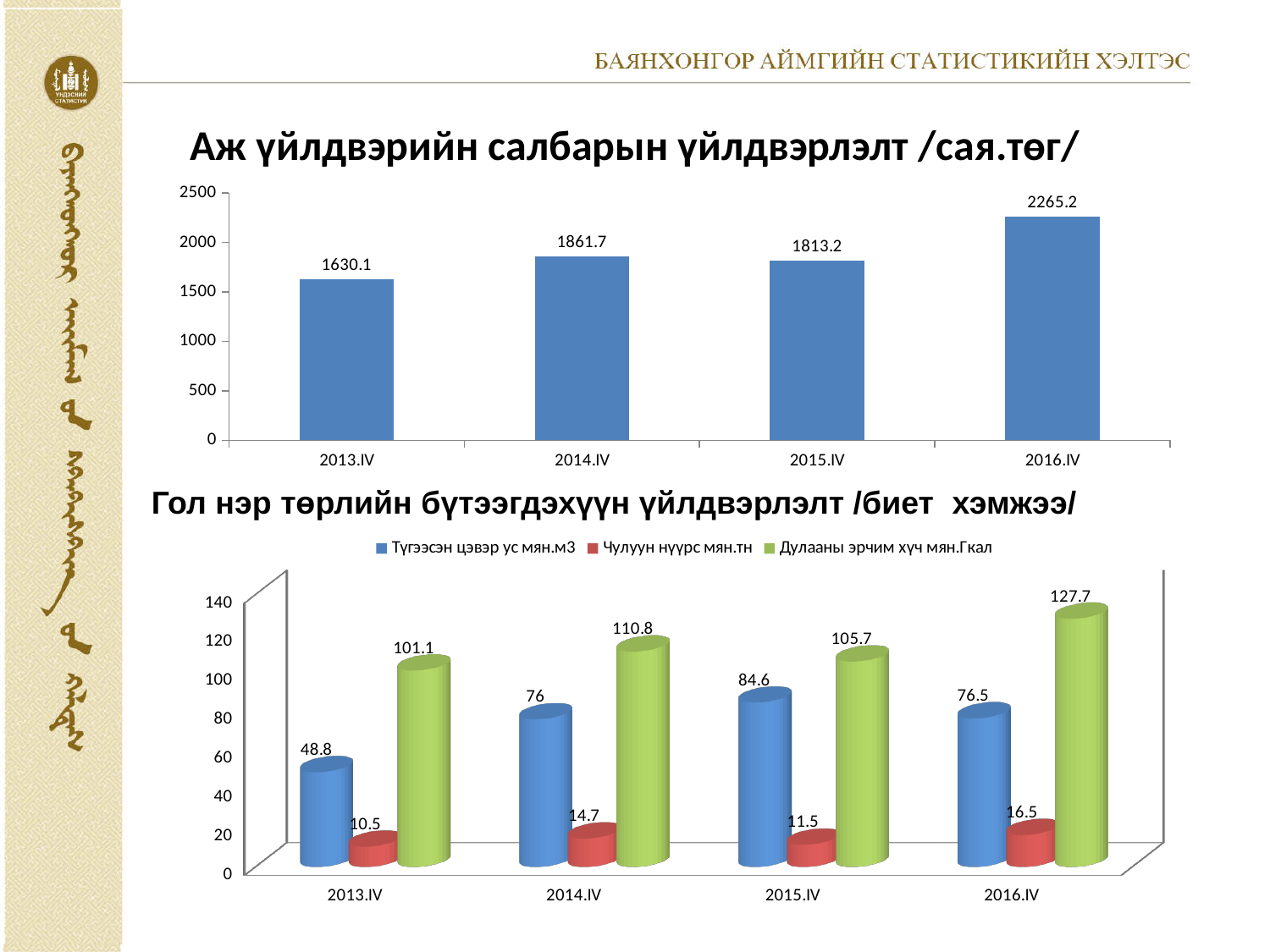
In the top chart 'Аж үйлдвэрийн салбарын үйлдвэрлэлт /сая.төг/', what is the difference between the values for 2016.IV and 2015.IV? 452.0 In the bottom chart 'Гол нэр төрлийн бүтээгдэхүүн үйлдвэрлэлт /биет хэмжээ/', how many series does the legend list? 3 In the bottom chart 'Гол нэр төрлийн бүтээгдэхүүн үйлдвэрлэлт /биет хэмжээ/', what is the value of 'Дулааны эрчим хүч мян.Гкал' for 2016.IV? 127.7 In the top chart 'Аж үйлдвэрийн салбарын үйлдвэрлэлт /сая.төг/', how many periods are shown on the x axis? 4 In the bottom chart 'Гол нэр төрлийн бүтээгдэхүүн үйлдвэрлэлт /биет хэмжээ/', which is larger for 2013.IV: 'Түгээсэн цэвэр ус мян.м3' or 'Дулааны эрчим хүч мян.Гкал'? Дулааны эрчим хүч мян.Гкал In the top chart 'Аж үйлдвэрийн салбарын үйлдвэрлэлт /сая.төг/', what is the value for 2014.IV? 1861.7 In the bottom chart 'Гол нэр төрлийн бүтээгдэхүүн үйлдвэрлэлт /биет хэмжээ/', what is the value of 'Чулуун нүүрс мян.тн' for 2014.IV? 14.7 In the top chart 'Аж үйлдвэрийн салбарын үйлдвэрлэлт /сая.төг/', which period has the highest value? 2016.IV In the top chart 'Аж үйлдвэрийн салбарын үйлдвэрлэлт /сая.төг/', which period has the lowest value? 2013.IV In the bottom chart 'Гол нэр төрлийн бүтээгдэхүүн үйлдвэрлэлт /биет хэмжээ/', what is the difference between 'Түгээсэн цэвэр ус мян.м3' for 2014.IV and 2013.IV? 27.2 What kind of chart is the top chart 'Аж үйлдвэрийн салбарын үйлдвэрлэлт /сая.төг/'? Bar chart In the bottom chart 'Гол нэр төрлийн бүтээгдэхүүн үйлдвэрлэлт /биет хэмжээ/', in which period is 'Түгээсэн цэвэр ус мян.м3' highest? 2015.IV